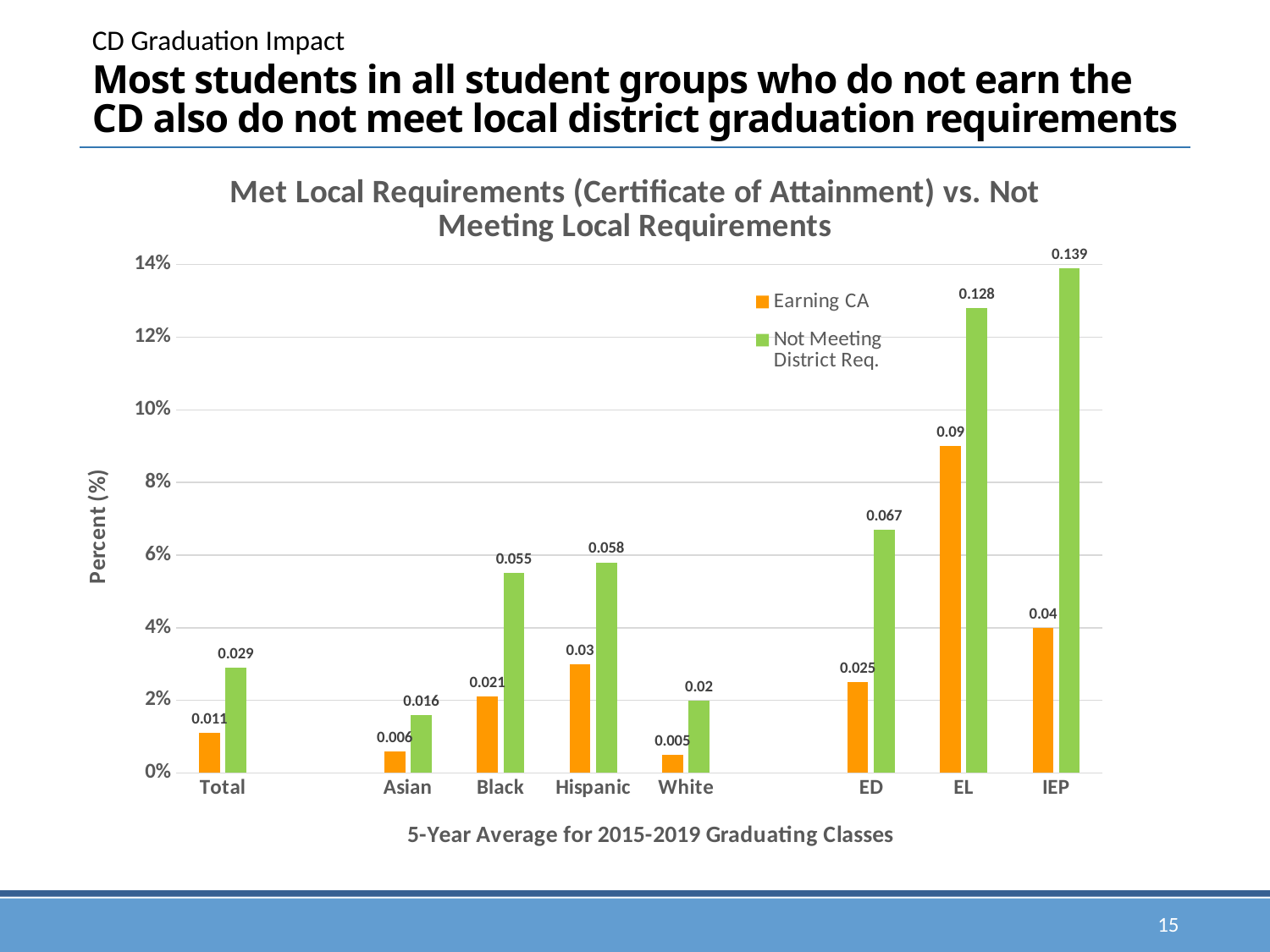
What is the label on the y axis of the chart? Percent (%) How many series does the legend list? 2 What is the value for Not Meeting District Req. in the IEP category? 0.139 What is the value for Earning CA in the Total category? 0.011 Which category has the highest value for Not Meeting District Req.? IEP How many student group categories are shown on the x axis? 8 Which is larger for Hispanic: the Earning CA value or the Not Meeting District Req. value? Not Meeting District Req. What kind of chart is shown on the slide? Bar chart Is the Not Meeting District Req. bar for EL greater or less than 10%? greater Which category has the lowest value for Earning CA? White What is the difference between the Not Meeting District Req. value and the Earning CA value for ED? 0.042 What is the value for Earning CA in the EL category? 0.09